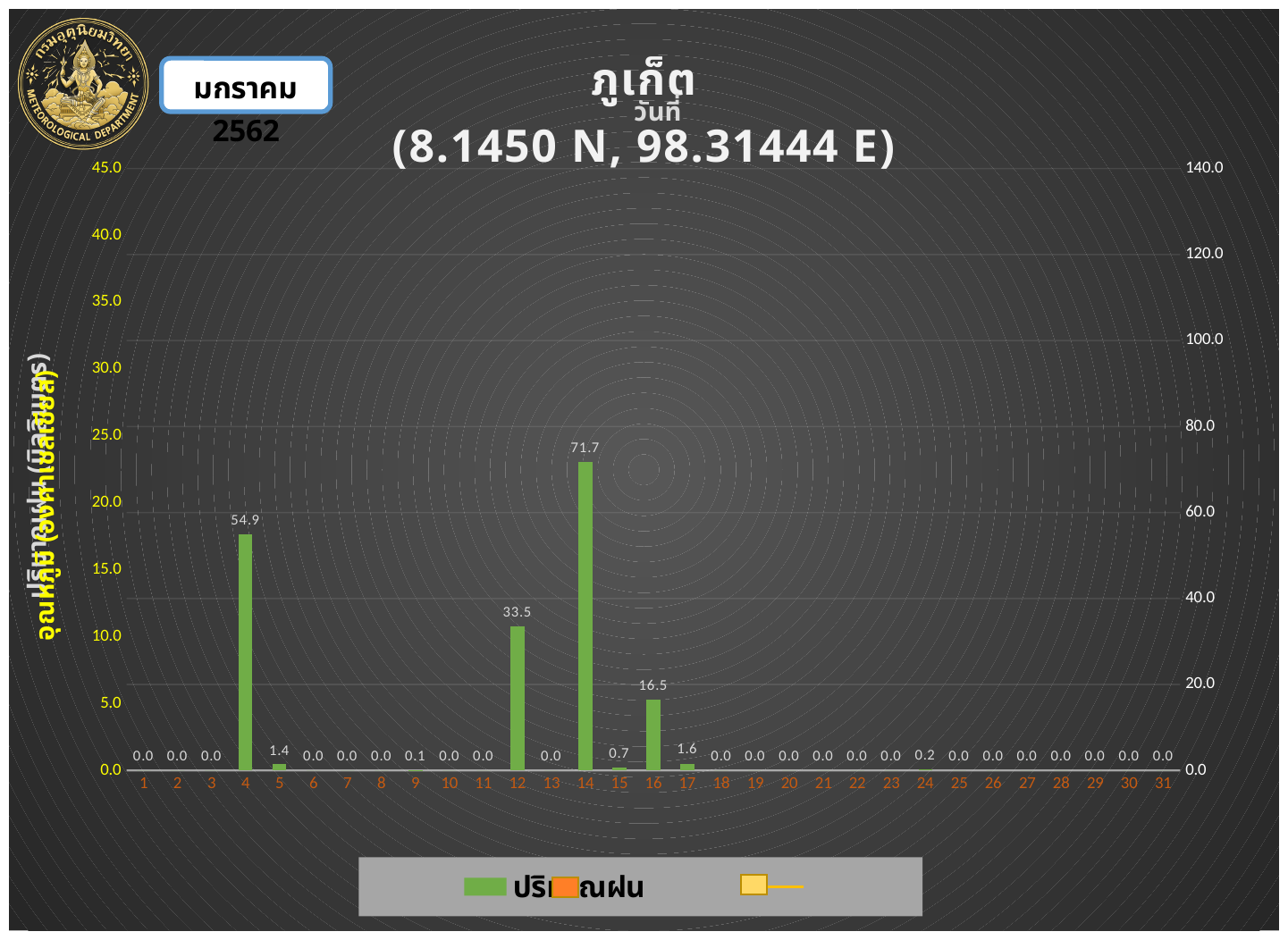
How many days are shown on the x axis? 31 What is the rainfall value shown for day 12? 33.5 What is the difference between the rainfall values for day 14 and day 4? 16.8 What are the coordinates shown in the chart title? 8.1450 N, 98.31444 E What kind of chart is shown on the slide? bar chart What is the rainfall value shown for day 24? 0.2 What is the difference between the rainfall values for day 12 and day 16? 17.0 What is the rainfall value shown for day 16? 16.5 What is the rainfall value shown for day 14? 71.7 Which day has the highest rainfall value? 14 What is the rainfall value shown for day 4? 54.9 Which is larger, the rainfall value for day 5 or for day 17? day 17